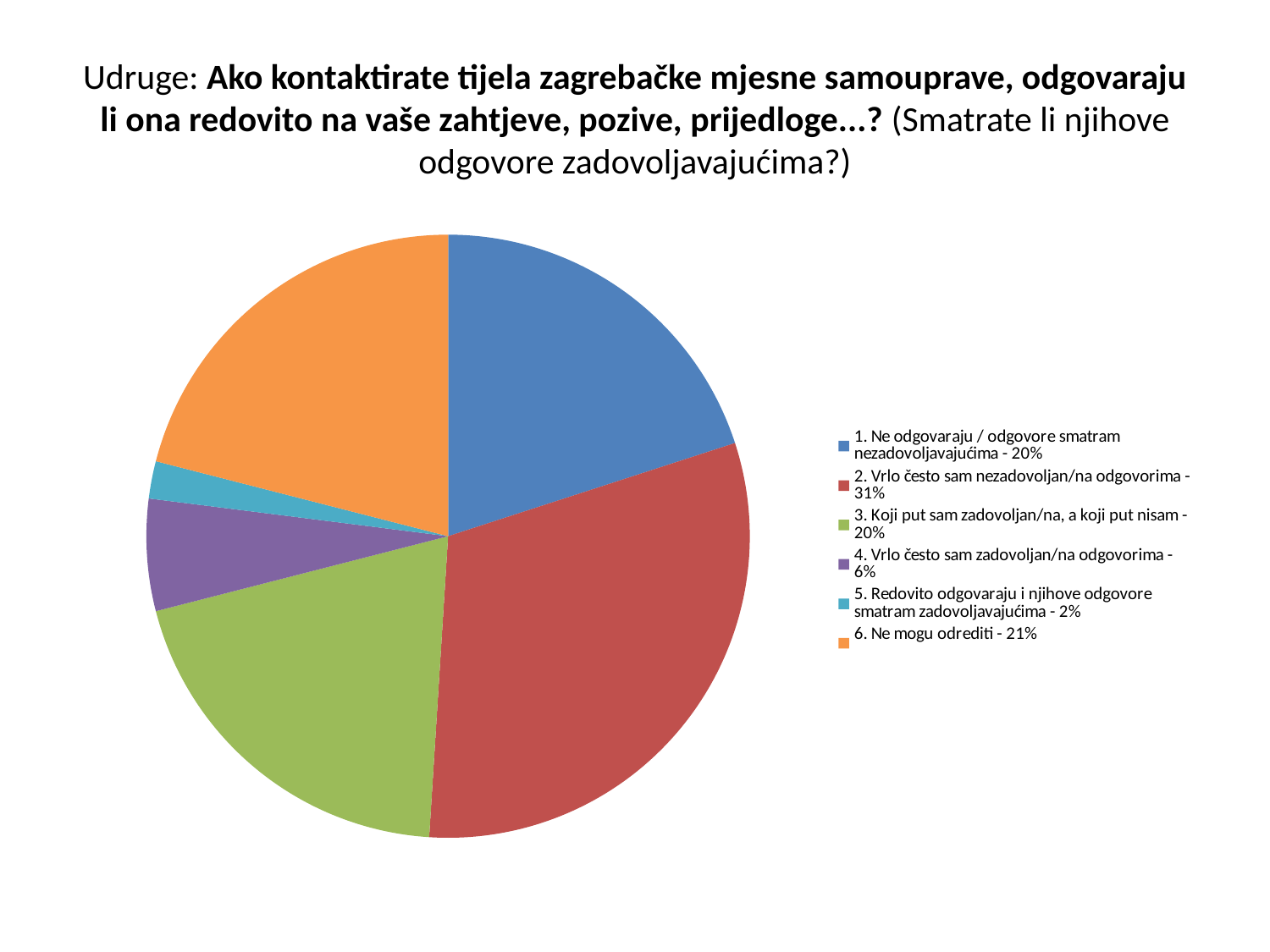
What share of the pie does "2. Vrlo često sam nezadovoljan/na odgovorima" have? 31% What is the value for "4. Vrlo često sam zadovoljan/na odgovorima"? 6% Which is larger: the share for "6. Ne mogu odrediti" or for "3. Koji put sam zadovoljan/na, a koji put nisam"? 6. Ne mogu odrediti Which category has the largest share of the pie? 2. Vrlo često sam nezadovoljan/na odgovorima What is the difference in percentage points between "2. Vrlo često sam nezadovoljan/na odgovorima" and "1. Ne odgovaraju / odgovore smatram nezadovoljavajućima"? 11 What is the difference in percentage points between "4. Vrlo često sam zadovoljan/na odgovorima" and "5. Redovito odgovaraju i njihove odgovore smatram zadovoljavajućima"? 4 What colour is the slice for "6. Ne mogu odrediti"? orange What is the value for "6. Ne mogu odrediti"? 21% What is the value for "5. Redovito odgovaraju i njihove odgovore smatram zadovoljavajućima"? 2% What kind of chart is shown on the slide? pie chart How many categories does the pie chart have? 6 Which category has the smallest share of the pie? 5. Redovito odgovaraju i njihove odgovore smatram zadovoljavajućima